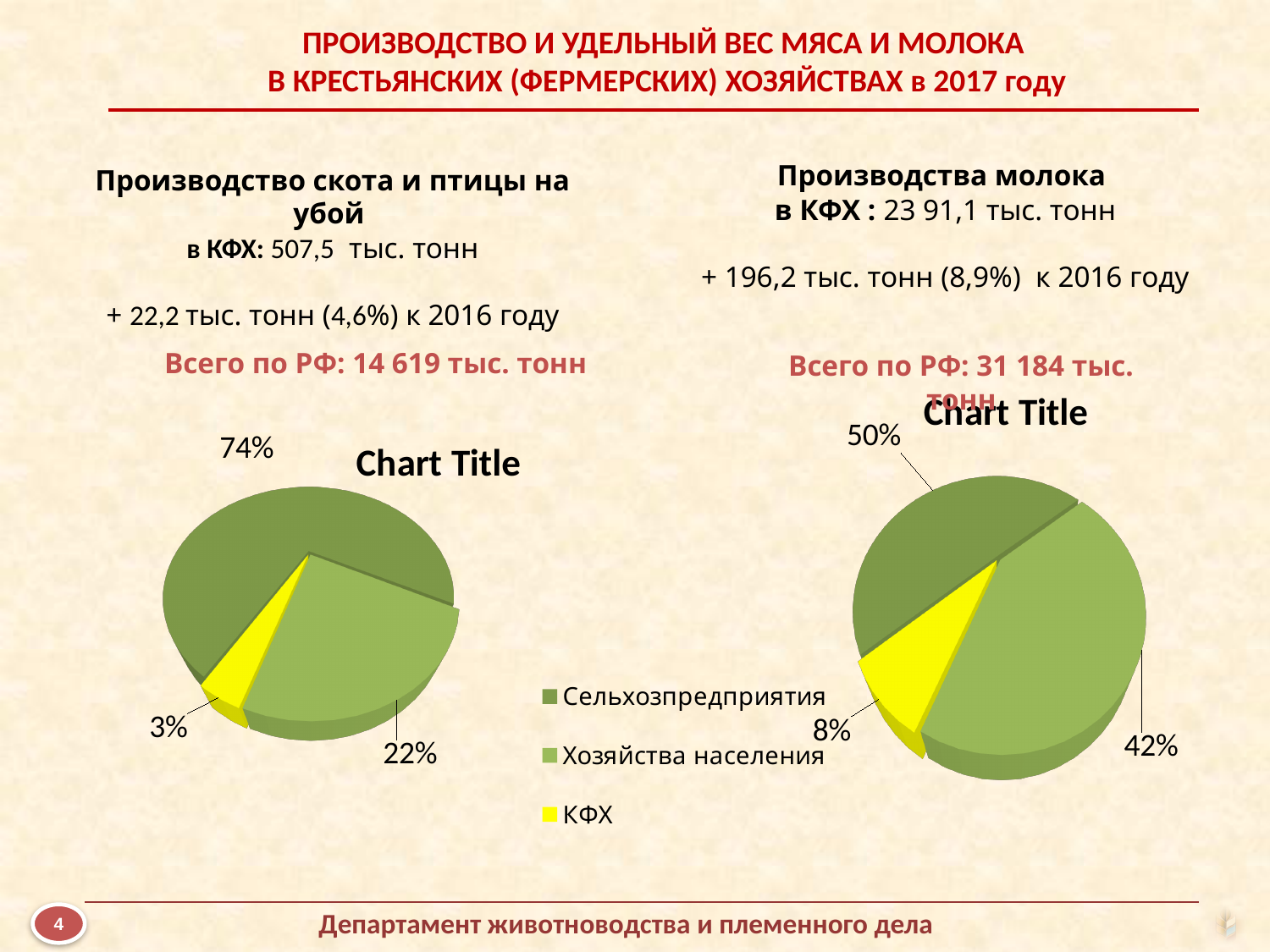
On the left pie chart, what share is labelled for the dark green slice (Сельхозпредприятия)? 74% What type of chart is used on the left side of the slide? Pie chart On the left pie chart, which category has the largest slice? Сельхозпредприятия On the right pie chart, what is the difference between the Сельхозпредприятия share and the Хозяйства населения share? 8% How many entries does the legend list? 3 On the left pie chart, what share is labelled for the yellow slice (КФХ)? 3% On the right pie chart, what share is labelled for the dark green slice (Сельхозпредприятия)? 50% On the right pie chart, which category has the smallest slice? КФХ Which is larger: the КФХ share on the left pie chart or the КФХ share on the right pie chart? The right pie chart